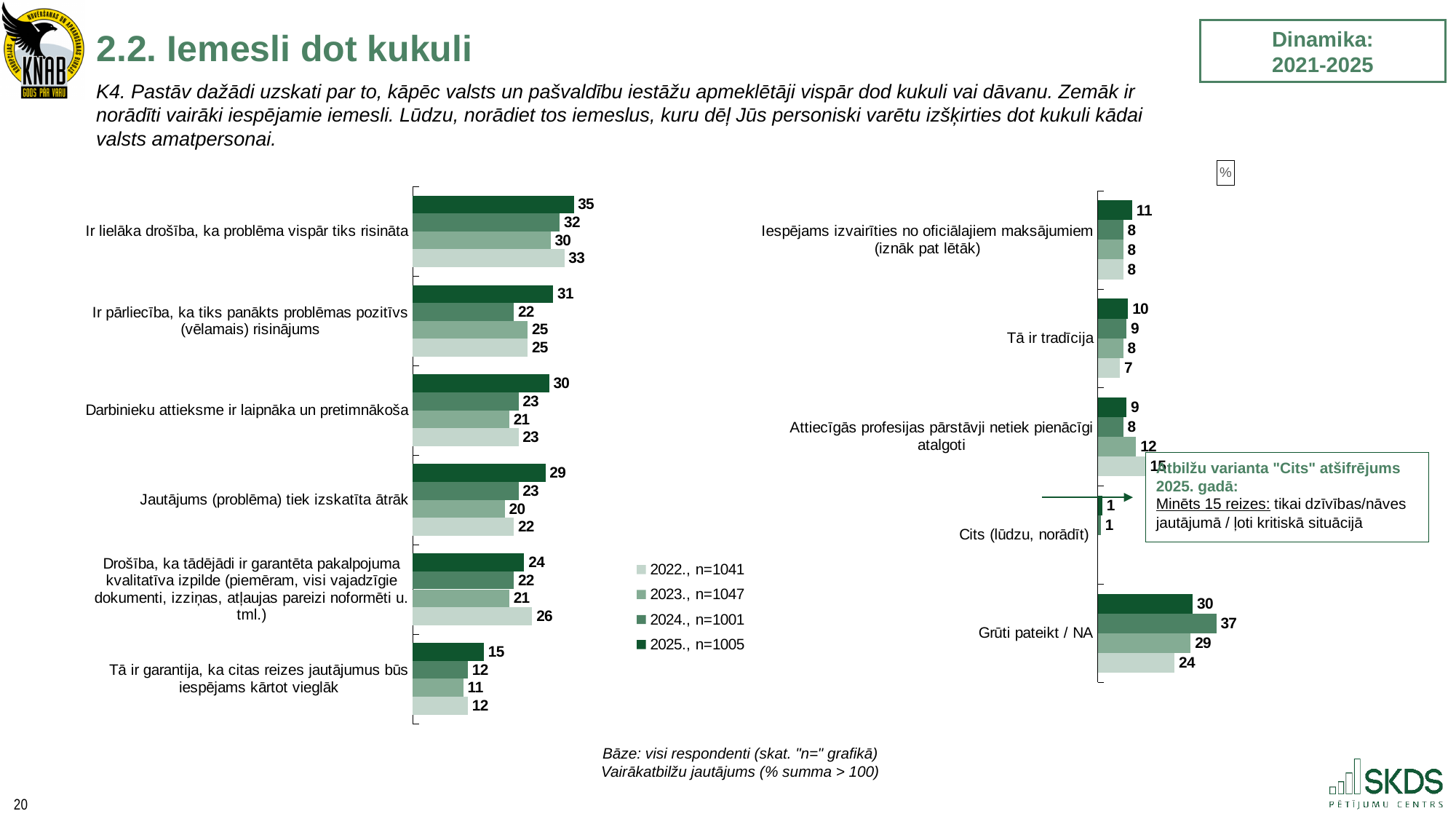
In the right chart, which is larger for "Tā ir tradīcija": the 2025 value or the 2022 value? 2025 In the right chart, what is the 2022 value for "Attiecīgās profesijas pārstāvji netiek pienācīgi atalgoti"? 15 In the right chart, what is the 2024 value for "Grūti pateikt / NA"? 37 In the left chart, what is the 2025 value for "Ir lielāka drošība, ka problēma vispār tiks risināta"? 35 In the left chart, which category has the highest 2025 value? Ir lielāka drošība, ka problēma vispār tiks risināta What type of chart is used on this slide? Bar chart In the left chart, what is the difference between the 2025 and 2024 values for "Ir pārliecība, ka tiks panākts problēmas pozitīvs (vēlamais) risinājums"? 9 In the left chart, what is the 2022 value for "Drošība, ka tādējādi ir garantēta pakalpojuma kvalitatīva izpilde"? 26 In the left chart, which category has the lowest 2025 value? Tā ir garantija, ka citas reizes jautājumus būs iespējams kārtot vieglāk In the right chart, what is the difference between the 2024 and 2022 values for "Grūti pateikt / NA"? 13 How many categories are shown in the left chart? 6 How many series does the legend list? 4